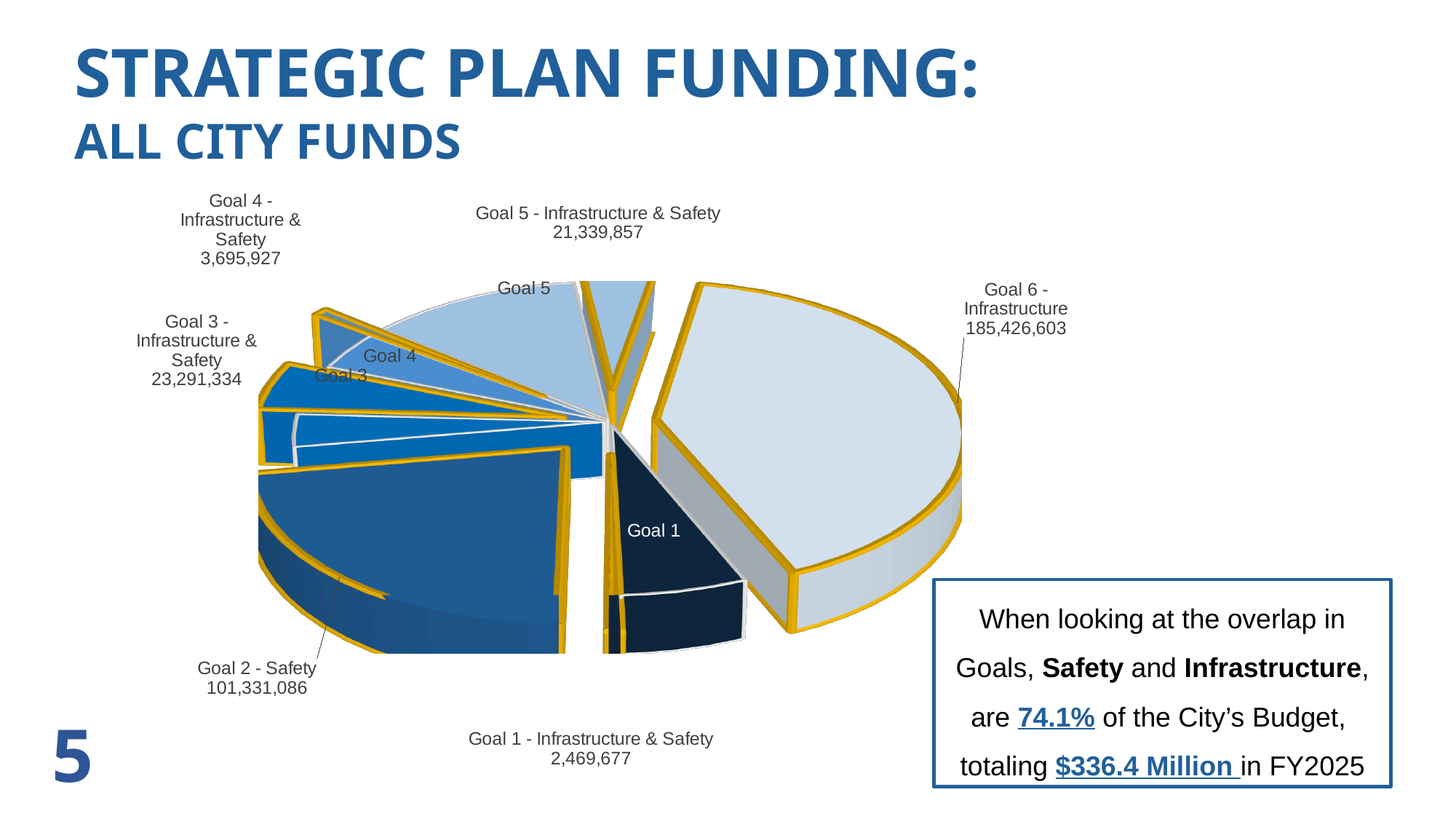
What is the value for Goal 1 - Infrastructure & Safety? 2,469,677 What is the value for Goal 2 - Safety? 101,331,086 What is the difference between the values for Goal 4 - Infrastructure & Safety and Goal 1 - Infrastructure & Safety? 1,226,250 What is the value for Goal 6 - Infrastructure? 185,426,603 What is the value for Goal 3 - Infrastructure & Safety? 23,291,334 How many slices does the pie chart have? 10 According to the text box on the slide, what percentage of the City's Budget do Safety and Infrastructure goals make up? 74.1% What kind of chart is shown on the slide? Pie chart Which goal has the largest slice of the pie? Goal 6 - Infrastructure Which goal has the smallest slice of the pie? Goal 1 - Infrastructure & Safety What is the difference between the values for Goal 6 - Infrastructure and Goal 2 - Safety? 84,095,517 Which is larger, the value for Goal 3 - Infrastructure & Safety or Goal 5 - Infrastructure & Safety? Goal 3 - Infrastructure & Safety